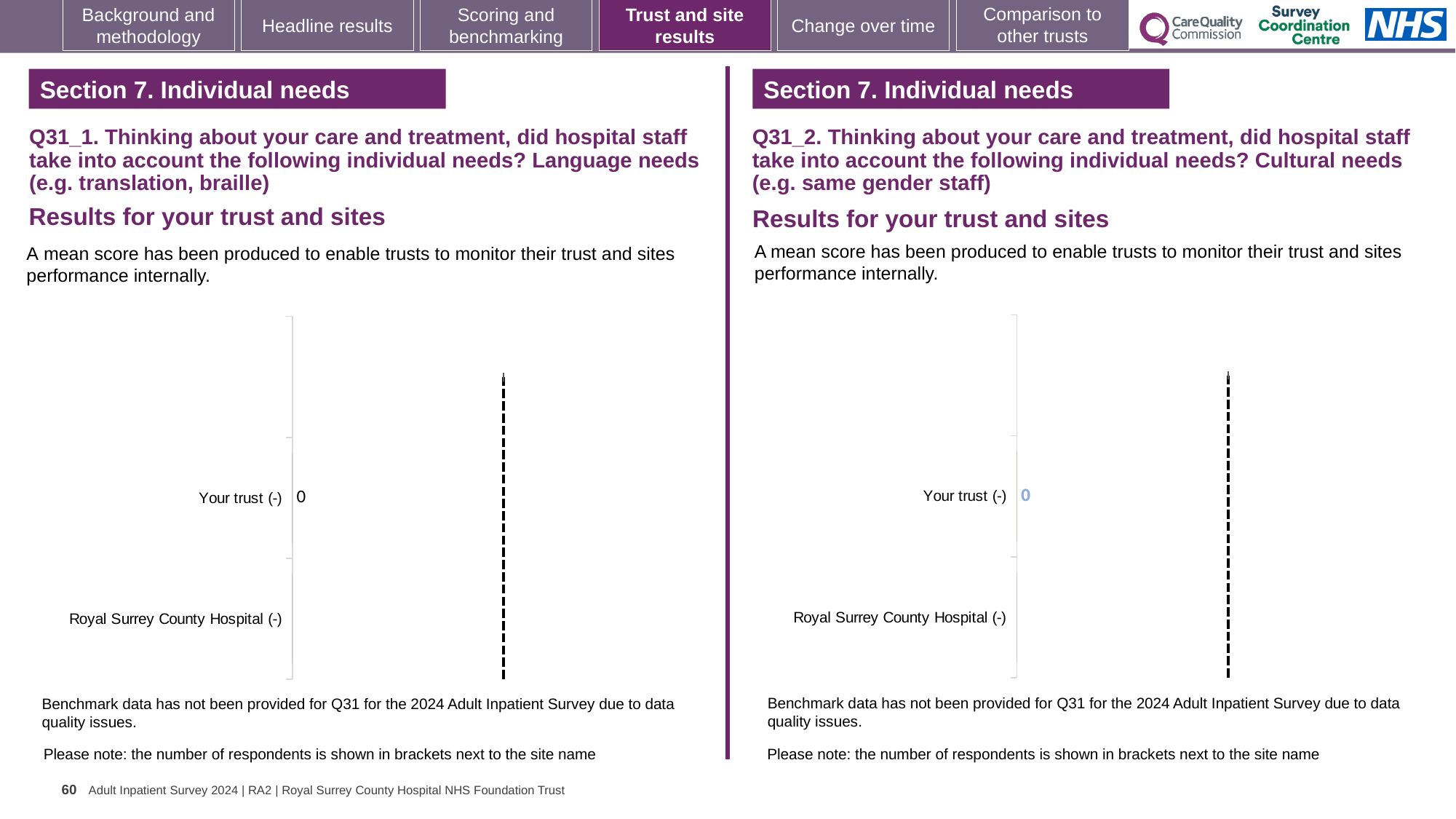
What kind of chart is used on the right side of the slide (Q31_2, Cultural needs)? bar chart On the left chart (Q31_1, Language needs), what value is shown for Your trust (-)? 0 On the right chart (Q31_2, Cultural needs), what value is shown for Your trust (-)? 0 How many categories are listed on the right chart (Q31_2, Cultural needs)? 2 What kind of chart is used on the left side of the slide (Q31_1, Language needs)? bar chart On the left chart (Q31_1, Language needs), which category is listed below Your trust (-)? Royal Surrey County Hospital (-) On the right chart (Q31_2, Cultural needs), what is the first category listed? Your trust (-) How many categories are listed on the left chart (Q31_1, Language needs)? 2